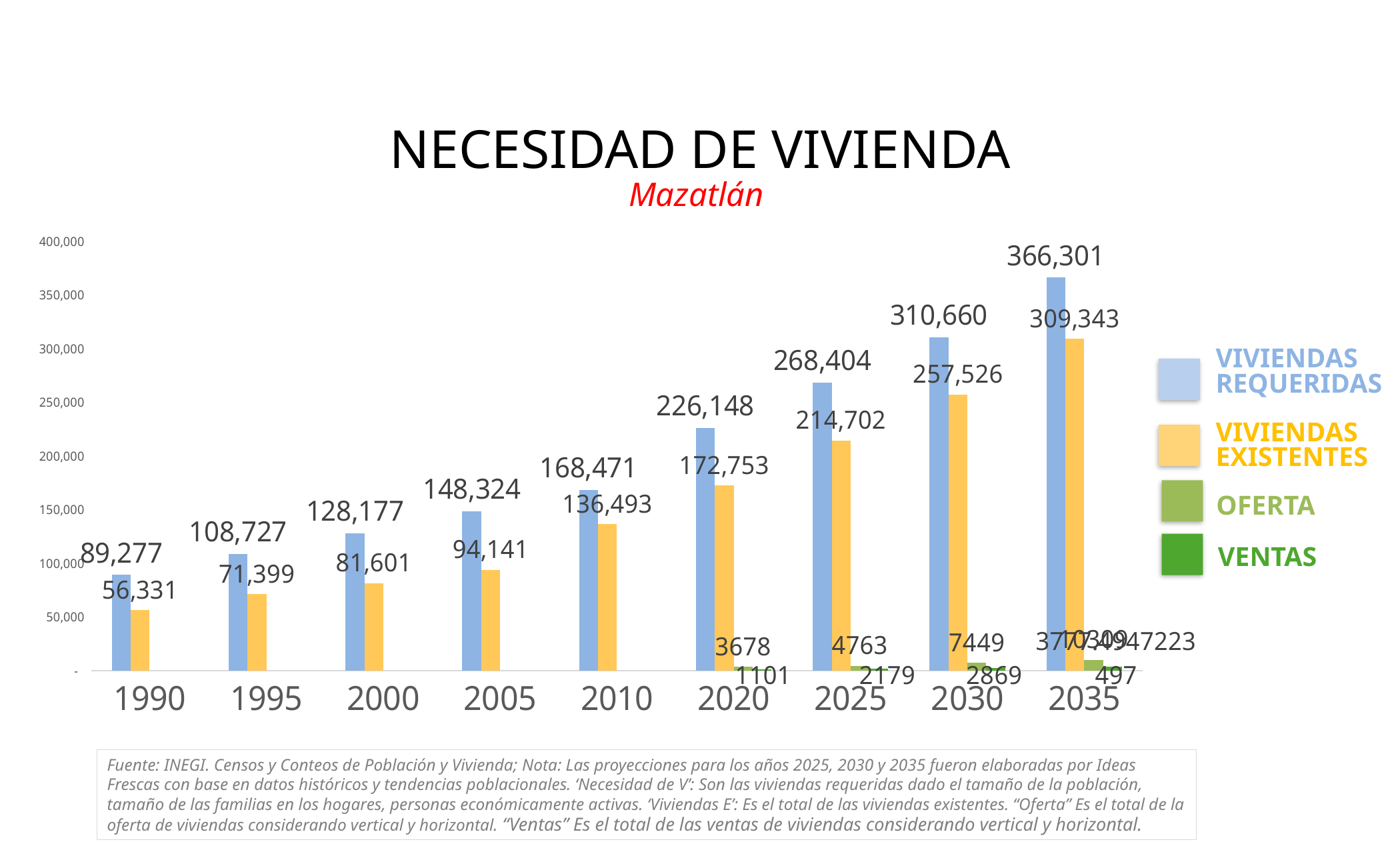
What is the difference between VIVIENDAS REQUERIDAS and VIVIENDAS EXISTENTES in 2030? 53,134 What is the value of VIVIENDAS REQUERIDAS for 2035? 366,301 What is the VENTAS value for 2025? 2179 What is the difference between VIVIENDAS REQUERIDAS and VIVIENDAS EXISTENTES in 1990? 32,946 In which year is VIVIENDAS EXISTENTES lowest? 1990 How many series does the legend list? 4 Which is larger: VIVIENDAS REQUERIDAS in 2020 or VIVIENDAS EXISTENTES in 2025? VIVIENDAS REQUERIDAS in 2020 How many years are shown on the x axis? 9 What is the value of VIVIENDAS EXISTENTES for 2010? 136,493 What is the OFERTA value for 2030? 7449 Do the VIVIENDAS REQUERIDAS values rise or fall from 1990 to 2035? rise In which year is VIVIENDAS REQUERIDAS highest? 2035